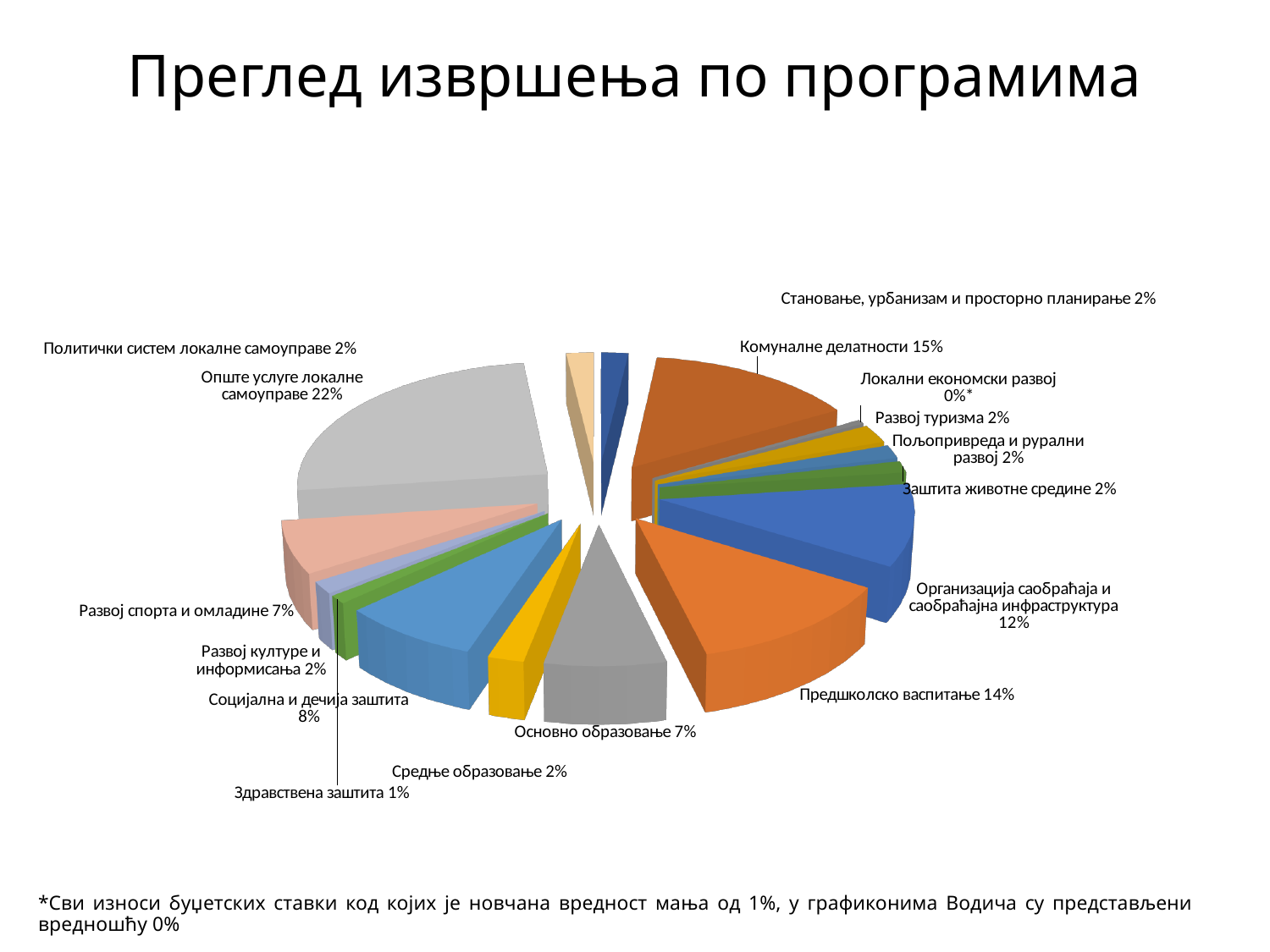
Which program has the smallest share of the pie? Локални економски развој What is the value shown for Здравствена заштита? 1% What is the value shown for Организација саобраћаја и саобраћајна инфраструктура? 12% What is the title of the chart on the slide? Преглед извршења по програмима How many program categories are shown in the pie chart? 16 What share of the pie does Опште услуге локалне самоуправе have? 22% What is the value shown for Комуналне делатности? 15% What is the difference in percentage points between Опште услуге локалне самоуправе and Комуналне делатности? 7 What kind of chart is shown on the slide? pie chart Which is larger, Социјална и дечија заштита or Основно образовање? Социјална и дечија заштита What is the value shown for Предшколско васпитање? 14% Which program has the largest share of the pie? Опште услуге локалне самоуправе